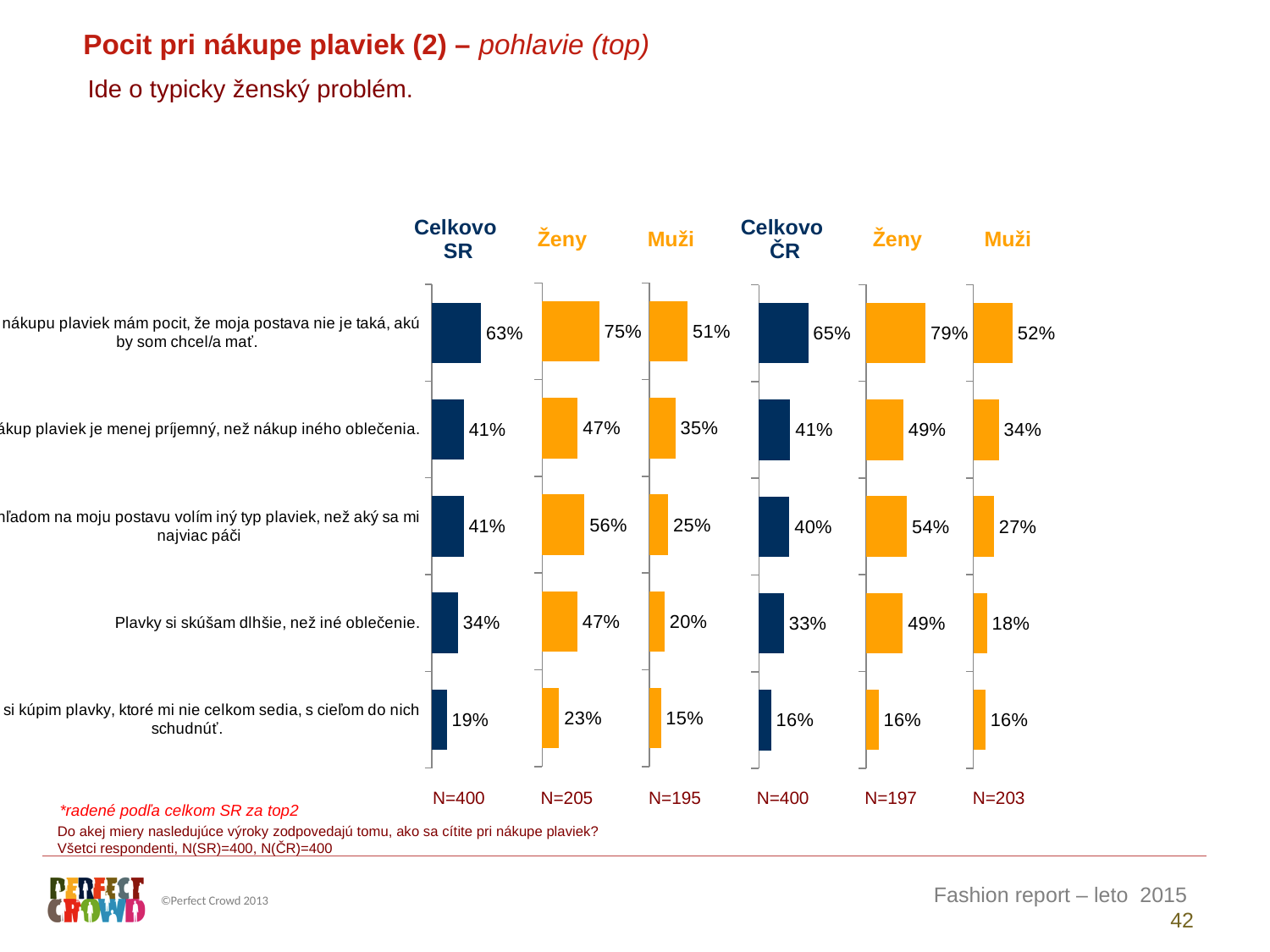
What type of chart is used on this slide? Bar chart In the Ženy chart of the SR group (second column), what is the value for the statement "Plavky si skúšam dlhšie, než iné oblečenie."? 47% For the statement "Plavky si skúšam dlhšie, než iné oblečenie.", what is the difference between the Ženy and Muži values in the SR group? 27 percentage points How many statements (categories) are shown in each chart? 5 What colour are the bars in the Celkovo SR and Celkovo ČR charts? Dark blue In the Muži chart of the ČR group (last column), what is the value for the statement "Plavky si skúšam dlhšie, než iné oblečenie."? 18% For the statement about choosing a different type of swimsuit because of one's figure ("...volím iný typ plaviek, než aký sa mi najviac páči"), which is larger: the Ženy value in the SR group or the Ženy value in the ČR group? Ženy in the SR group (56%) In the Celkovo SR chart, which statement has the highest value? ...moja postava nie je taká, akú by som chcel/a mať. (63%) In the Celkovo ČR chart, what is the value for the statement about feeling that one's figure is not as one would like it to be ("...moja postava nie je taká, akú by som chcel/a mať")? 65% In the Ženy chart of the ČR group (fifth column), which statement has the lowest value? ...s cieľom do nich schudnúť. (16%) What is the sample size (N) shown under the Muži chart of the SR group? N=195 In the Celkovo SR chart, what is the value for the statement "Plavky si skúšam dlhšie, než iné oblečenie."? 34%